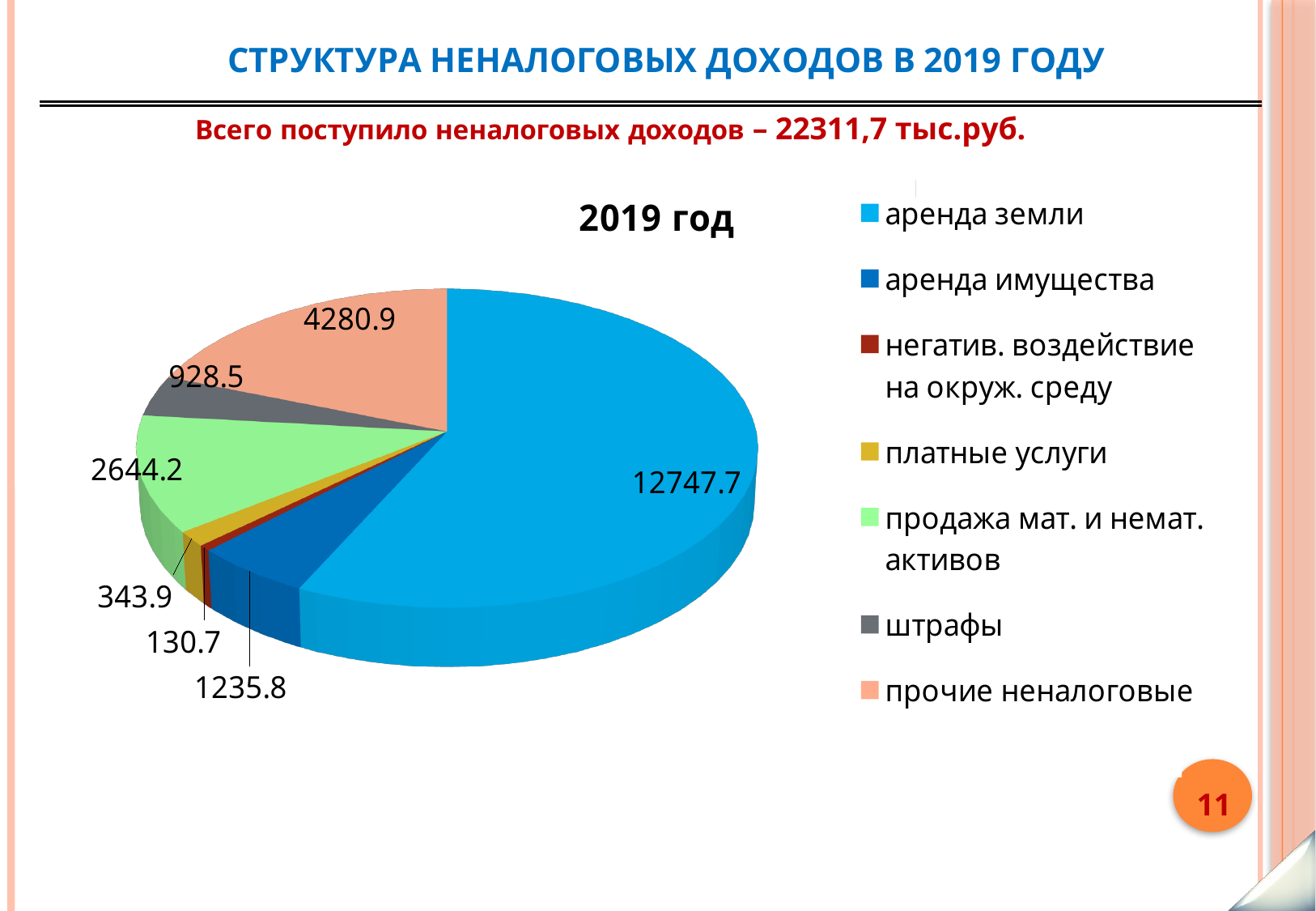
What is the title of the pie chart? 2019 год Which is larger: аренда имущества or платные услуги? аренда имущества How many slices does the pie chart have? 7 What is the value for прочие неналоговые in the pie chart? 4280.9 What kind of chart is shown on the slide? pie chart What is the difference between the values for прочие неналоговые and продажа мат. и немат. активов? 1636.7 Which category has the smallest slice in the pie chart? негатив. воздействие на окруж. среду What is the value for аренда земли in the 2019 год pie chart? 12747.7 Which category has the largest slice in the pie chart? аренда земли What is the total of all slices in the pie chart? 22311.7 What is the value for штрафы in the pie chart? 928.5 What is the value for негатив. воздействие на окруж. среду in the pie chart? 130.7